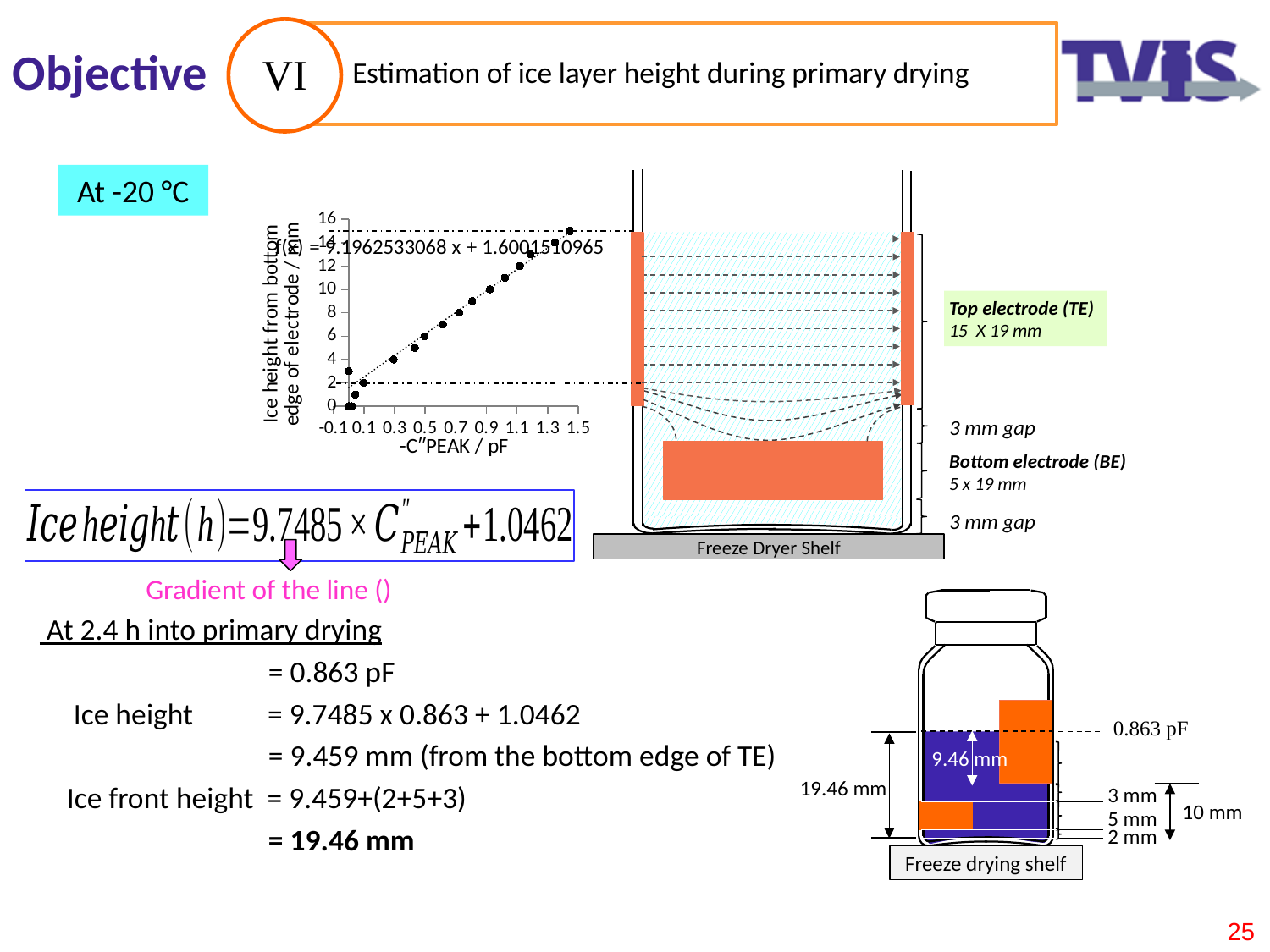
What is the label of the y axis of the chart? Ice height from bottom edge of electrode / mm Is the ice height of the point plotted at about 0.3 pF greater or less than 8? less What is the trendline equation printed on the chart? f(x) = 9.1962533068 x + 1.6001510965 What is the highest tick value shown on the x axis of the chart? 1.5 What is the highest tick value shown on the y axis of the chart? 16 What is the label of the x axis of the chart? -C″PEAK / pF Is the highest plotted ice height value greater or less than 10? greater What kind of chart is shown on the slide? scatter chart What is the slope of the trendline equation printed on the chart? 9.1962533068 What is the intercept of the trendline equation printed on the chart? 1.6001510965 Do the plotted ice height values rise or fall as -C″PEAK increases along the x axis? rise